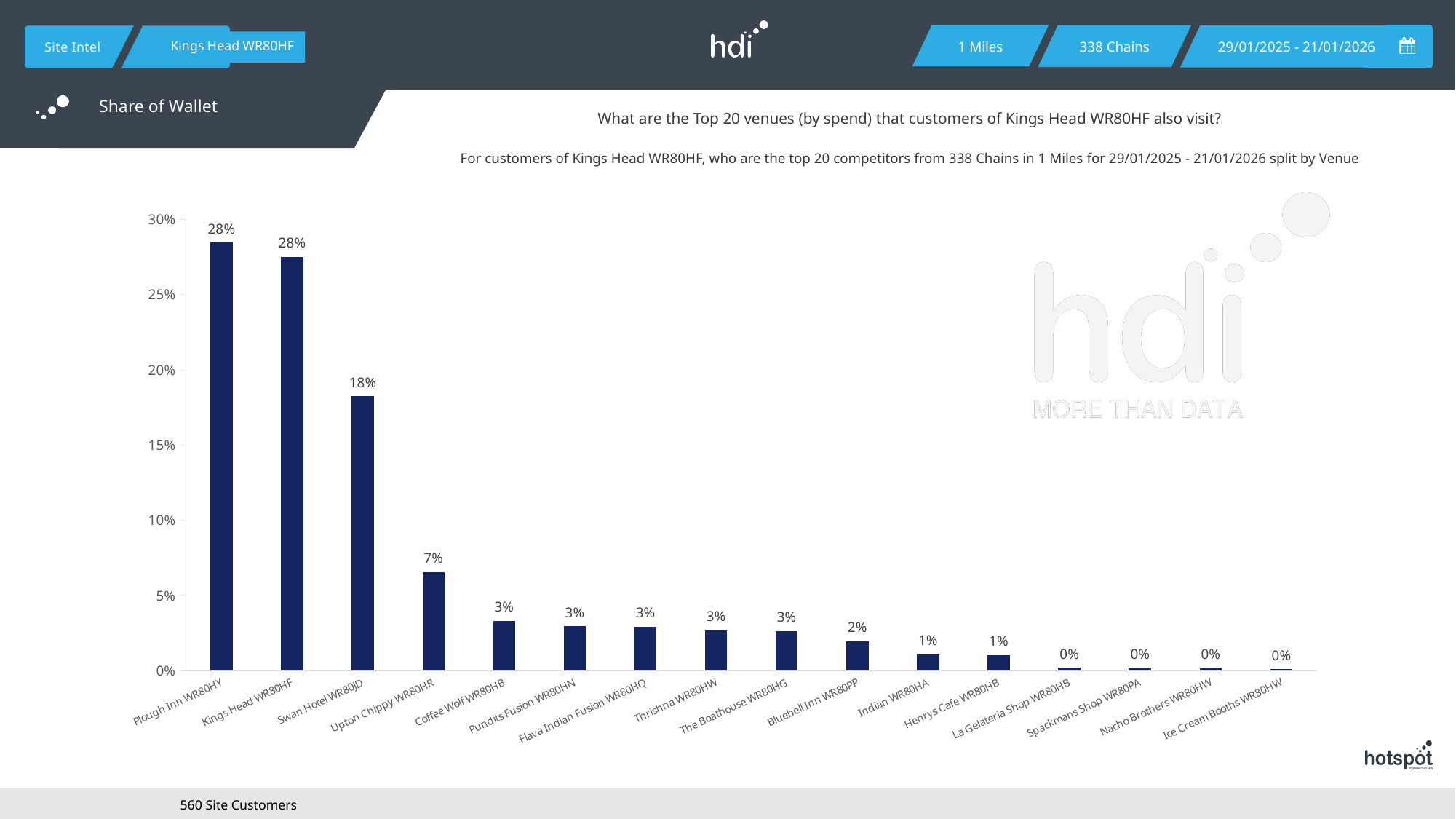
Which has a larger value, Swan Hotel WR80JD or Upton Chippy WR80HR? Swan Hotel WR80JD Do the values rise or fall from left to right along the x axis? fall How many venues are shown on the chart? 16 What is the value for Upton Chippy WR80HR? 7% What kind of chart is shown on the slide? bar chart What is the difference between the values for Swan Hotel WR80JD and Upton Chippy WR80HR? 11% What is the value for Swan Hotel WR80JD? 18% What is the value for Henrys Cafe WR80HB? 1% What is the value for Bluebell Inn WR80PP? 2% Is the value for Upton Chippy WR80HR greater or less than 5%? greater What is the value for Plough Inn WR80HY? 28% Is the value for Swan Hotel WR80JD greater or less than 20%? less